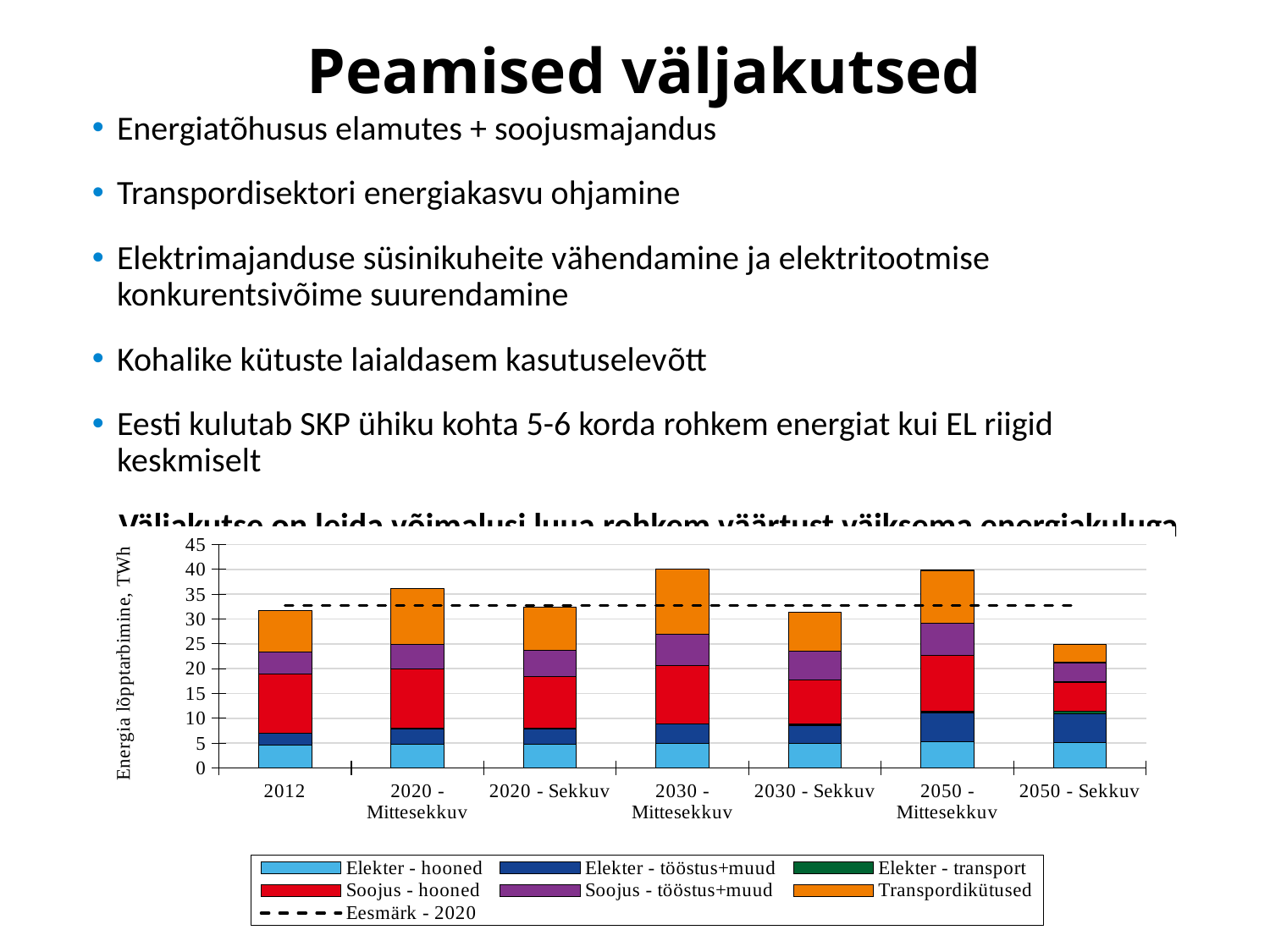
What is the label of the y axis of the chart? Energia lõpptarbimine, TWh Which has the larger total bar, 2050 - Mittesekkuv or 2050 - Sekkuv? 2050 - Mittesekkuv Which has the larger total bar, 2020 - Mittesekkuv or 2020 - Sekkuv? 2020 - Mittesekkuv How many entries does the chart legend list? 7 Which category has the lowest total bar in the chart? 2050 - Sekkuv Is the total value for 2012 greater or less than 30? greater What does the dashed horizontal line in the chart represent, according to the legend? Eesmärk - 2020 Is the total value for 2030 - Sekkuv greater or less than 35? less Is the total value for 2050 - Sekkuv greater or less than 30? less How many categories are shown along the x axis of the chart? 7 What kind of chart is shown on the slide? Stacked bar chart